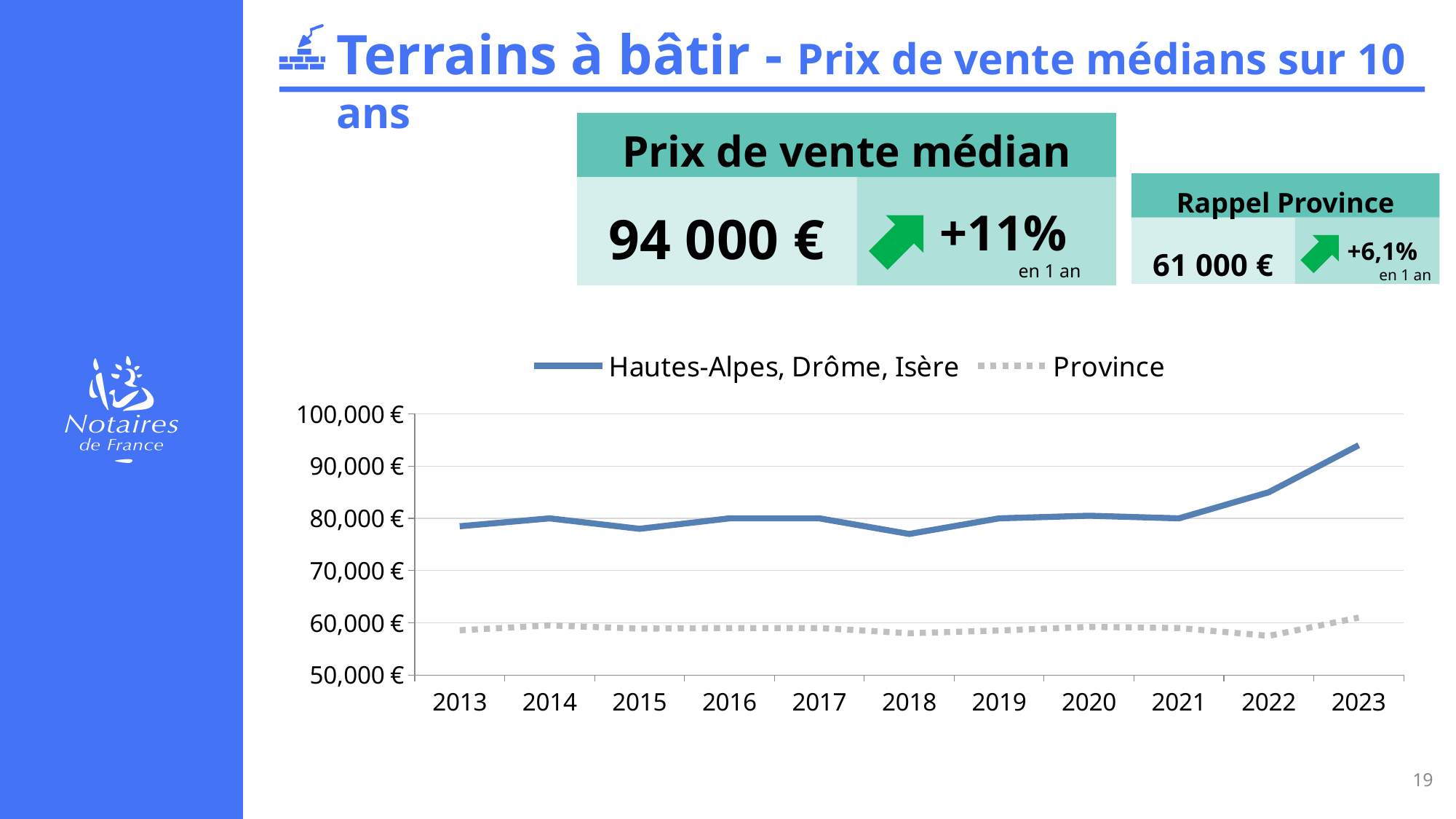
In which year is the Hautes-Alpes, Drôme, Isère series at its highest? 2023 Which series has the larger value in 2023, Hautes-Alpes, Drôme, Isère or Province? Hautes-Alpes, Drôme, Isère How many years are shown on the x axis of the chart? 11 Is the value for Province in 2022 greater or less than 60,000 €? less How many series does the chart legend list? 2 Is the value for Hautes-Alpes, Drôme, Isère in 2023 greater or less than 90,000 €? greater Is the value for Hautes-Alpes, Drôme, Isère in 2018 greater or less than 80,000 €? less Which series is drawn with a dotted grey line? Province What kind of chart is shown on the slide? line chart What is the name of the series drawn with the solid blue line? Hautes-Alpes, Drôme, Isère In which year is the Hautes-Alpes, Drôme, Isère series at its lowest? 2018 Does the Hautes-Alpes, Drôme, Isère series rise or fall between 2021 and 2023? rise